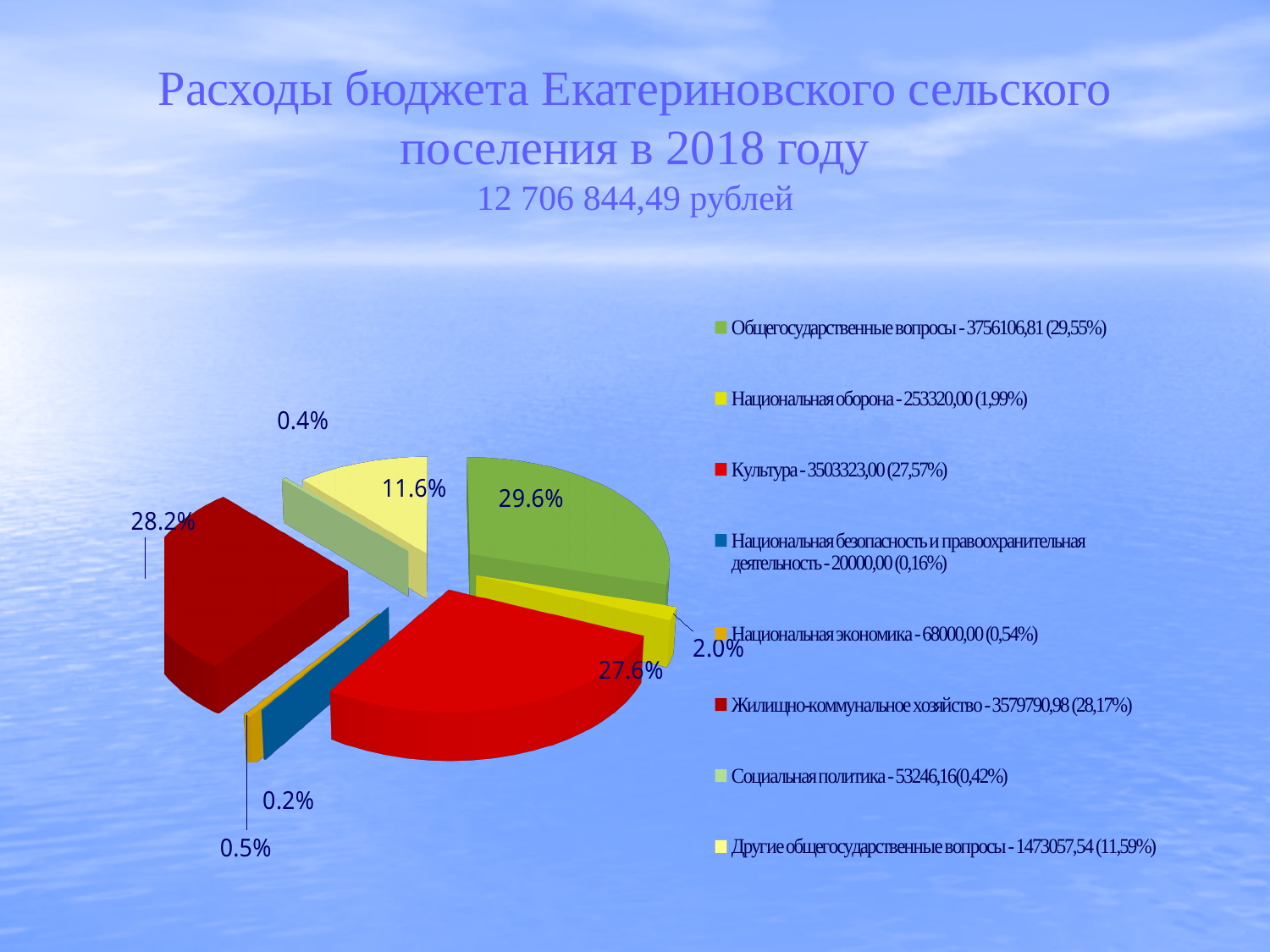
What kind of chart is shown on the slide? pie chart What percentage label is shown for Национальная оборона? 2.0% Which has the larger share: Культура or Жилищно-коммунальное хозяйство? Жилищно-коммунальное хозяйство Which category has the smallest share of the pie? Национальная безопасность и правоохранительная деятельность According to the legend, what amount in rubles is given for Культура? 3503323,00 Which category has the largest share of the pie? Общегосударственные вопросы What total budget expenditure amount is stated in the slide title? 12 706 844,49 рублей How many slices does the pie chart have? 8 What percentage label is shown for Жилищно-коммунальное хозяйство? 28.2% What is the difference in percentage points between the Общегосударственные вопросы slice (29.6%) and the Другие общегосударственные вопросы slice (11.6%)? 18.0% What percentage label is shown for Другие общегосударственные вопросы? 11.6% What percentage label is shown for Культура? 27.6%